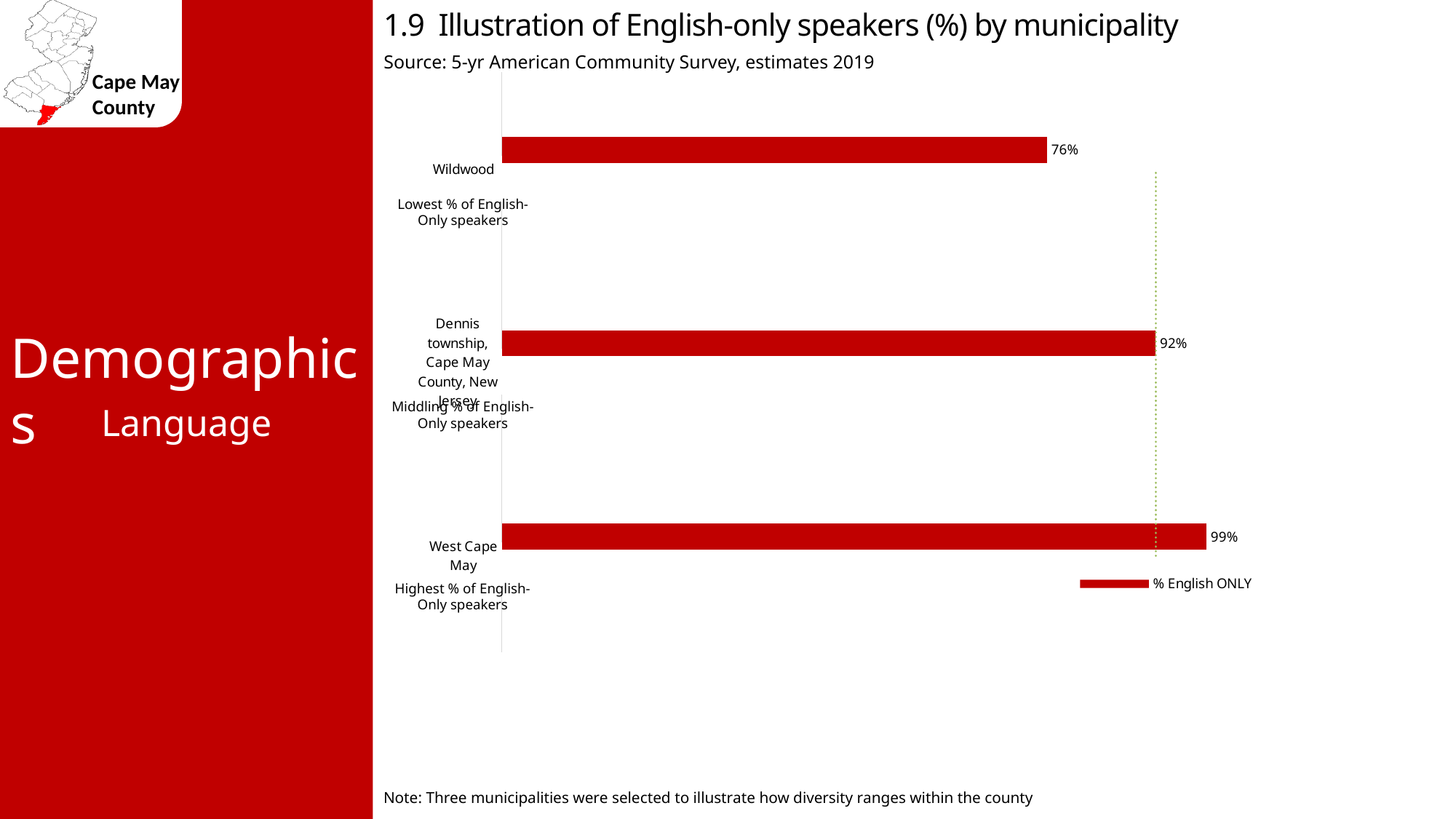
Which municipality has the highest percentage of English-only speakers? West Cape May Which has a higher percentage of English-only speakers, Dennis township or Wildwood? Dennis township How many municipalities are shown in the chart? 3 What is the difference in percentage points between Dennis township and Wildwood? 16 How many series does the legend list? 1 What is the percentage of English-only speakers in West Cape May? 99% What kind of chart is shown on the slide? Bar chart What is the legend entry for the series in the chart? % English ONLY What is the difference in percentage points between West Cape May and Wildwood? 23 Which municipality has the lowest percentage of English-only speakers? Wildwood What is the percentage of English-only speakers in Wildwood? 76% What is the percentage of English-only speakers in Dennis township? 92%